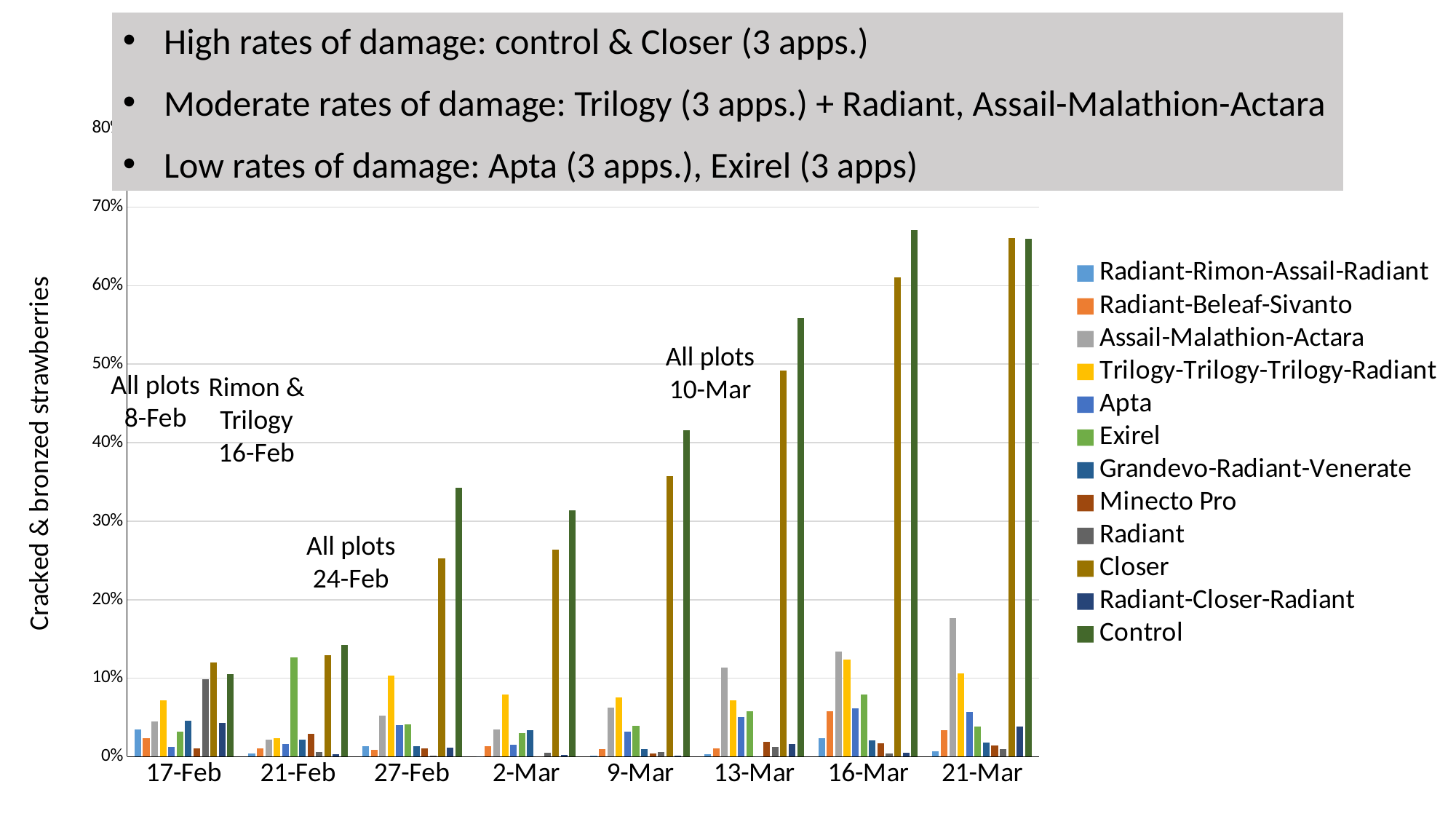
How many dates are shown along the x axis of the chart? 8 Which series has the highest value on 13-Mar? Control On 13-Mar, which is larger: the value for Control or the value for Closer? Control What is the title of the vertical axis? Cracked & bronzed strawberries Which legend entry is listed last in the chart's legend? Control Is the value for Closer on 9-Mar greater or less than 30%? greater Is the value for Control on 21-Mar greater or less than 60%? greater Is the value for Closer on 27-Feb greater or less than 20%? greater What kind of chart is shown on the slide? bar chart How many series does the chart's legend list? 12